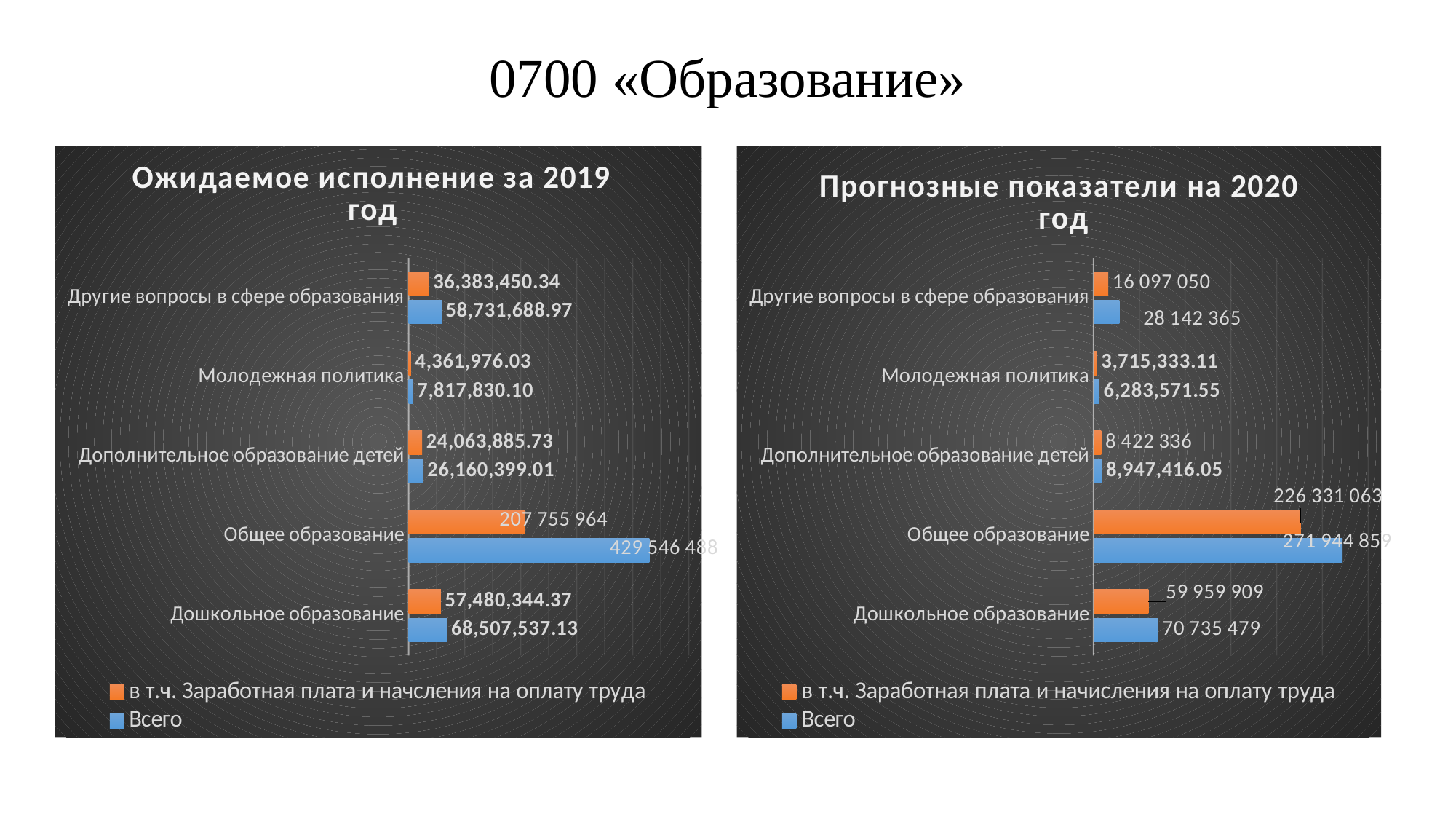
In the 'Прогнозные показатели на 2020 год' chart, which is larger: the 'Всего' value for 'Дошкольное образование' or the 'Всего' value for 'Другие вопросы в сфере образования'? Дошкольное образование In the 'Ожидаемое исполнение за 2019 год' chart, what is the 'Всего' value for 'Другие вопросы в сфере образования'? 58,731,688.97 In the 'Прогнозные показатели на 2020 год' chart, what is the 'Всего' value for 'Дошкольное образование'? 70 735 479 In the 'Ожидаемое исполнение за 2019 год' chart, what is the difference between the 'Всего' and the 'в т.ч. Заработная плата и начисления на оплату труда' values for 'Дошкольное образование'? 11,027,192.76 In the 'Ожидаемое исполнение за 2019 год' chart, which category has the lowest 'Всего' value? Молодежная политика In the 'Прогнозные показатели на 2020 год' chart, what is the 'в т.ч. Заработная плата и начисления на оплату труда' value for 'Дополнительное образование детей'? 8 422 336 In the 'Прогнозные показатели на 2020 год' chart, what is the difference between the 'Всего' and the 'в т.ч. Заработная плата и начисления на оплату труда' values for 'Другие вопросы в сфере образования'? 12 045 315 How many series does the legend of the 'Ожидаемое исполнение за 2019 год' chart list? 2 What type of chart is the 'Ожидаемое исполнение за 2019 год' chart? bar chart In the 'Ожидаемое исполнение за 2019 год' chart, which category has the highest 'Всего' value? Общее образование In the 'Ожидаемое исполнение за 2019 год' chart, what is the 'в т.ч. Заработная плата и начисления на оплату труда' value for 'Молодежная политика'? 4,361,976.03 How many categories are shown in the 'Прогнозные показатели на 2020 год' chart? 5